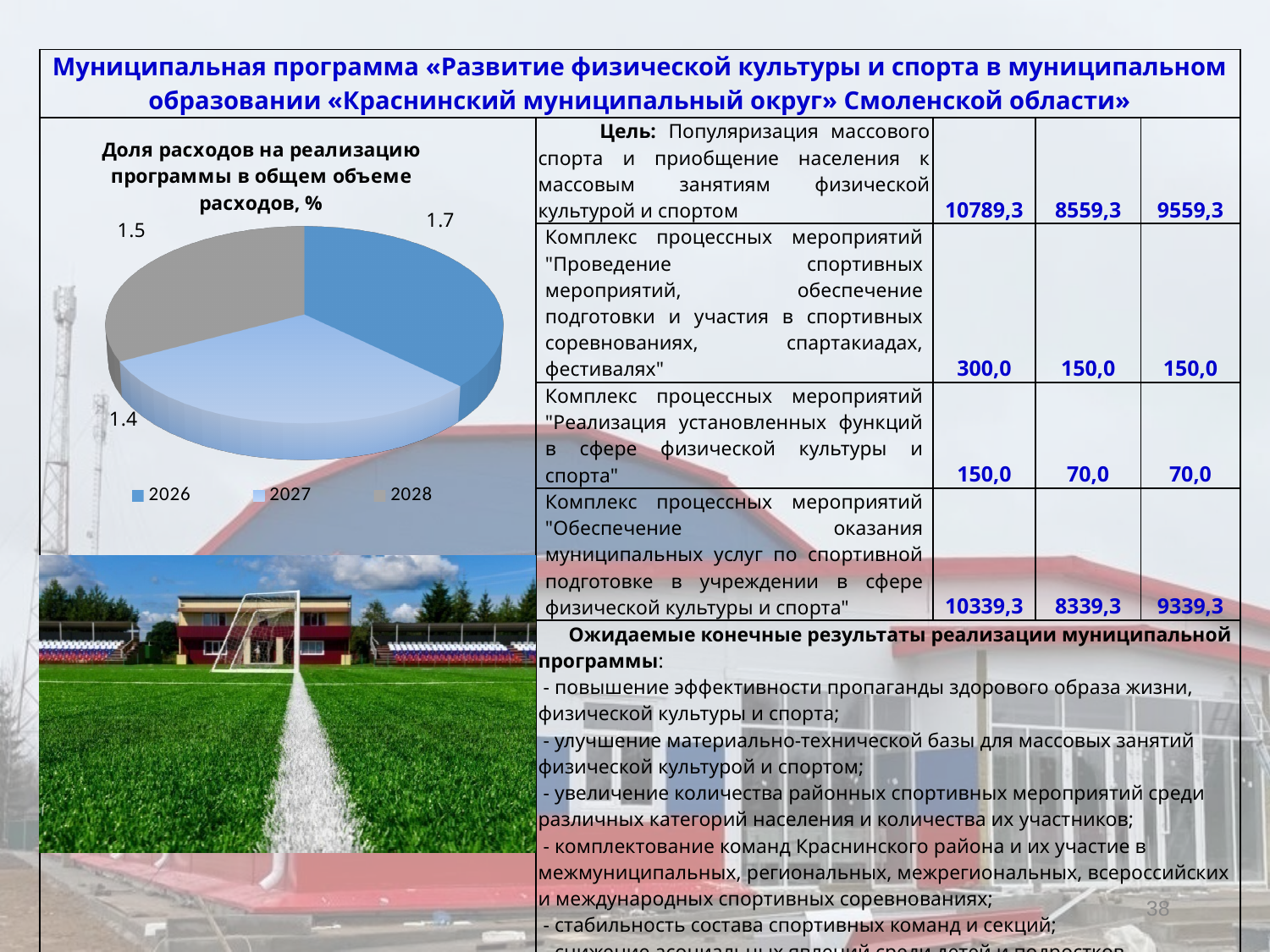
What is the value for 2027 in the pie chart? 1.4 How many slices does the pie chart have? 3 What is the difference between the values for 2026 and 2027 in the pie chart? 0.3 What is the title of the pie chart? Доля расходов на реализацию программы в общем объеме расходов, % What kind of chart is shown on the slide? Pie chart Which year has the highest value in the pie chart? 2026 How many entries does the legend of the pie chart list? 3 Which year has the lowest value in the pie chart? 2027 What is the value for 2026 in the pie chart? 1.7 Which is larger in the pie chart, the value for 2026 or the value for 2028? 2026 What is the difference between the values for 2028 and 2027 in the pie chart? 0.1 What is the value for 2028 in the pie chart? 1.5